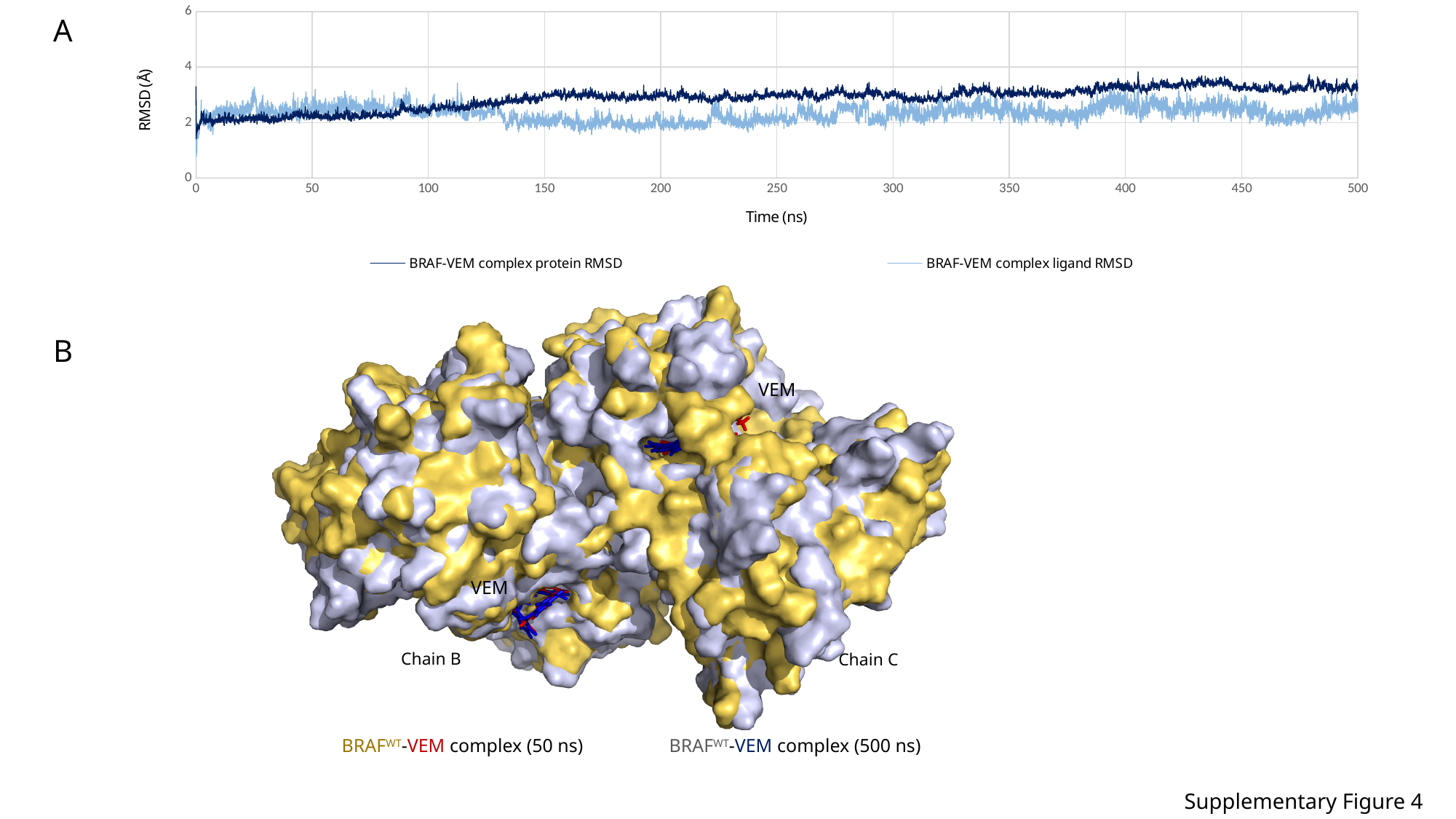
In the chart in panel A, what is the maximum value shown on the y axis? 6 In the chart in panel A, what is the label of the x axis? Time (ns) In the chart in panel A, is the BRAF-VEM complex protein RMSD at 450 ns greater or less than 2? greater In the chart in panel A, what is the last time value labelled on the x axis? 500 In the chart in panel A, at 300 ns, which series has the lower RMSD: BRAF-VEM complex protein RMSD or BRAF-VEM complex ligand RMSD? BRAF-VEM complex ligand RMSD How many series does the legend of the chart in panel A list? 2 In the chart in panel A, does the BRAF-VEM complex protein RMSD generally rise or fall from 0 ns to 500 ns? rise What kind of chart is panel A? line chart In the chart in panel A, what is the label of the y axis? RMSD (Å) In the chart in panel A, is the BRAF-VEM complex ligand RMSD at 450 ns greater or less than 4? less In the chart in panel A, at 400 ns, which series has the higher RMSD: BRAF-VEM complex protein RMSD or BRAF-VEM complex ligand RMSD? BRAF-VEM complex protein RMSD In the chart in panel A, is the BRAF-VEM complex protein RMSD at 450 ns greater or less than 4? less